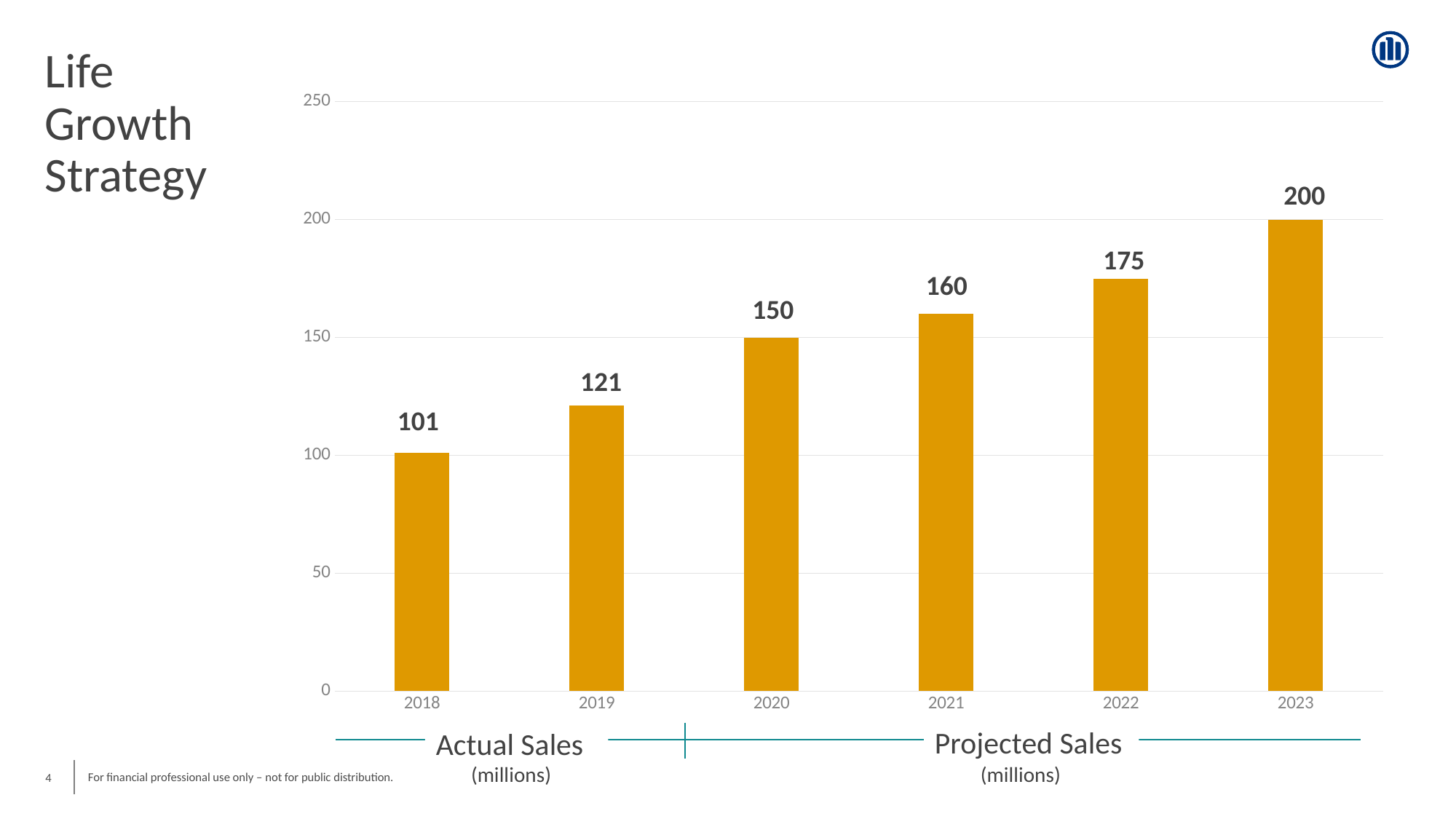
What is the value for 2021? 160 Do the values rise or fall from 2018 to 2023? rise What kind of chart is shown on the slide? bar chart Which year has the highest value? 2023 What is the difference between the values for 2020 and 2019? 29 Is the value for 2019 greater or less than 150? less What is the value for 2023? 200 What is the difference between the values for 2023 and 2018? 99 What is the value for 2018? 101 Which is larger, the value for 2022 or the value for 2020? 2022 Which year has the lowest value? 2018 How many years are shown on the x axis? 6